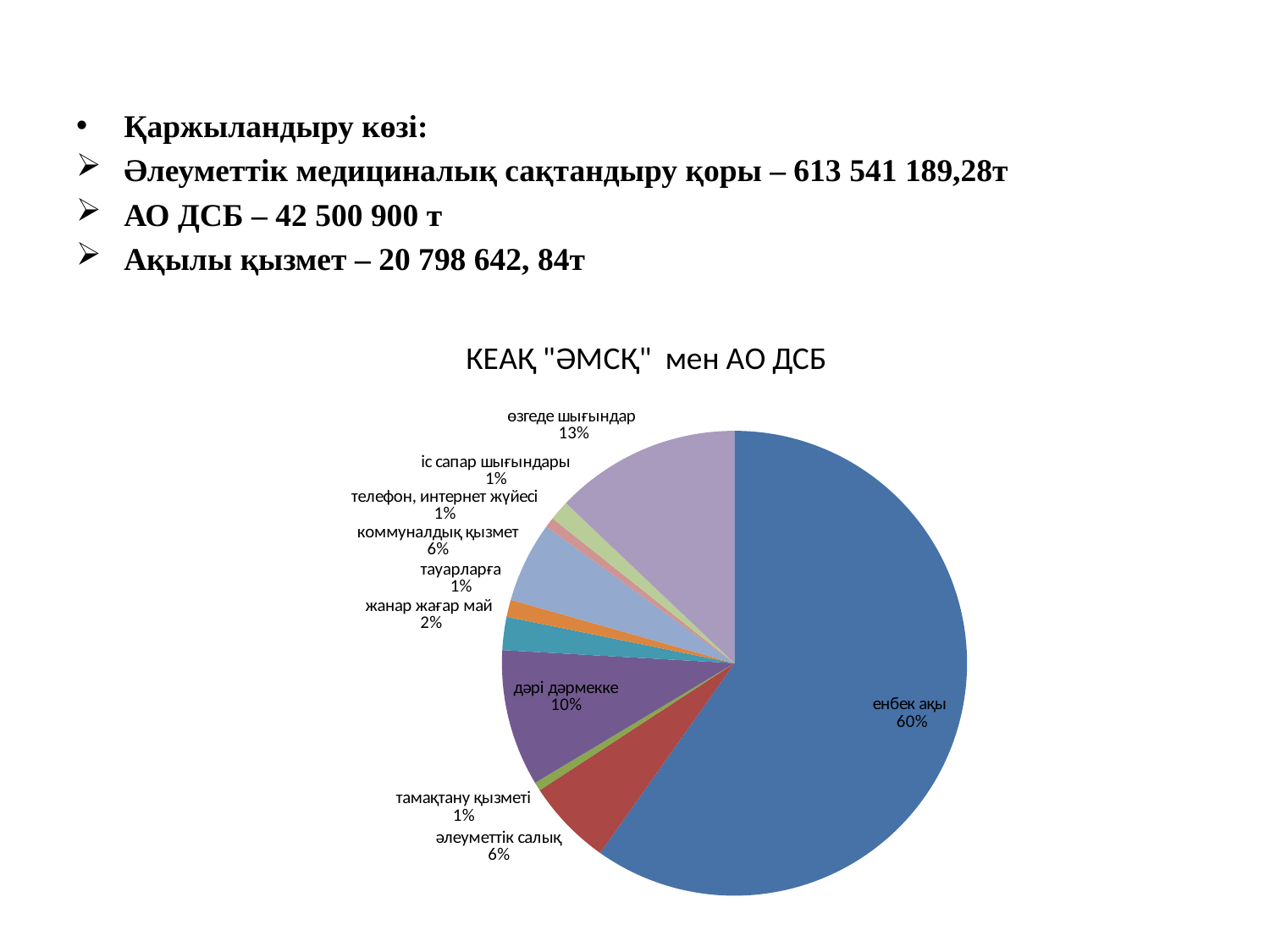
What is the title of the pie chart? КЕАҚ "ӘМСҚ" мен АО ДСБ How many slices does the pie chart have? 10 Which category has the largest slice of the pie? енбек ақы What share of the pie does енбек ақы take? 60% What share of the pie does дәрі дәрмекке take? 10% What share of the pie does коммуналдық қызмет take? 6% What is the difference between the share for енбек ақы and the share for өзгеде шығындар? 47% Which is larger, the share for өзгеде шығындар or the share for дәрі дәрмекке? өзгеде шығындар What is the difference between the share for дәрі дәрмекке and the share for әлеуметтік салық? 4% What kind of chart is shown on the slide? pie chart